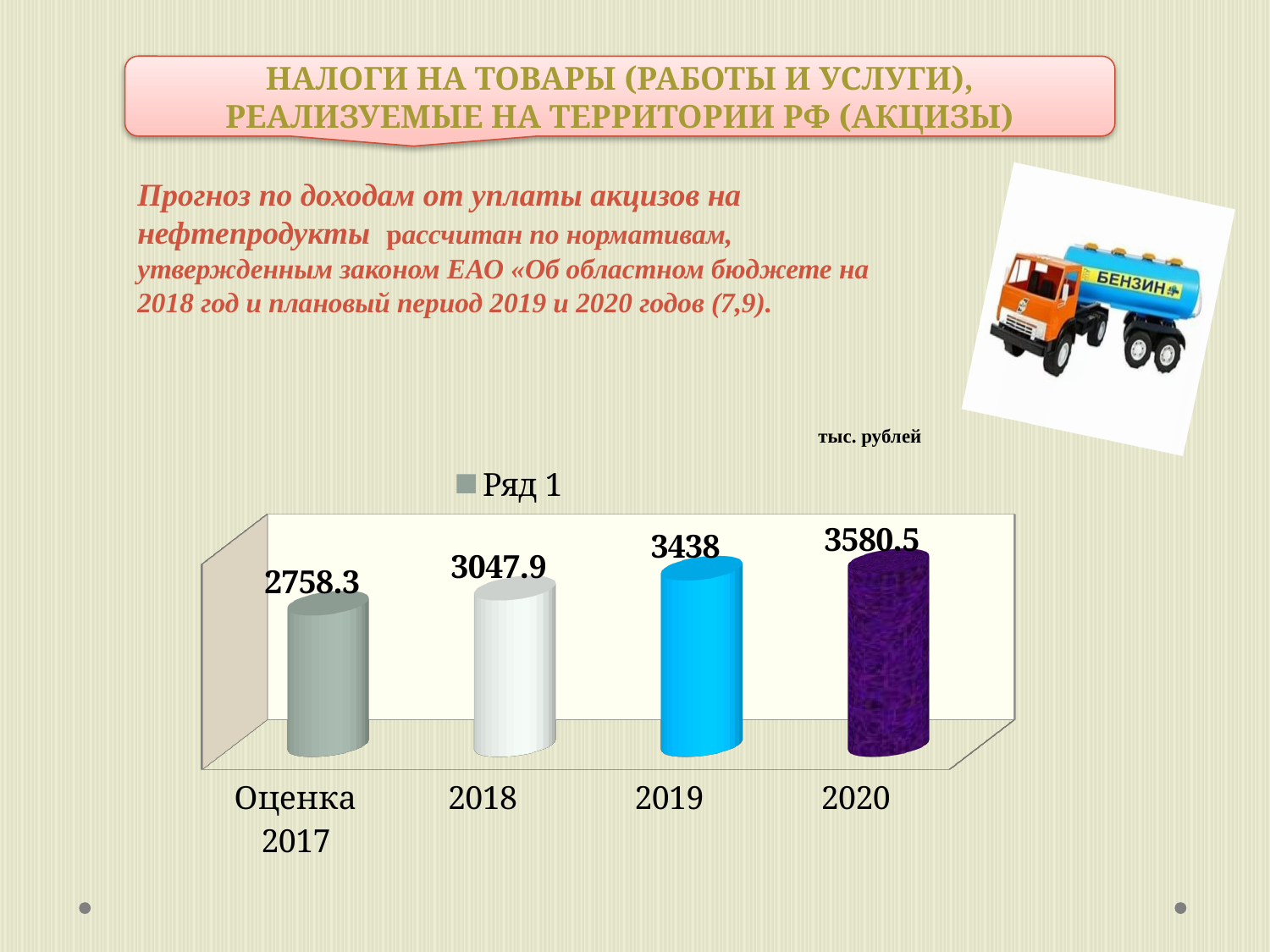
What is the value for Оценка 2017? 2758.3 Which is larger, the value for 2019 or the value for 2018? 2019 What is the difference between the values for 2020 and 2019? 142.5 What series name does the legend show? Ряд 1 What is the value for 2020? 3580.5 Which category has the highest value? 2020 Which category has the lowest value? Оценка 2017 What is the difference between the values for 2018 and Оценка 2017? 289.6 What is the value for 2018? 3047.9 What is the value for 2019? 3438 Do the values rise or fall from Оценка 2017 to 2020? rise How many categories are shown on the x axis? 4